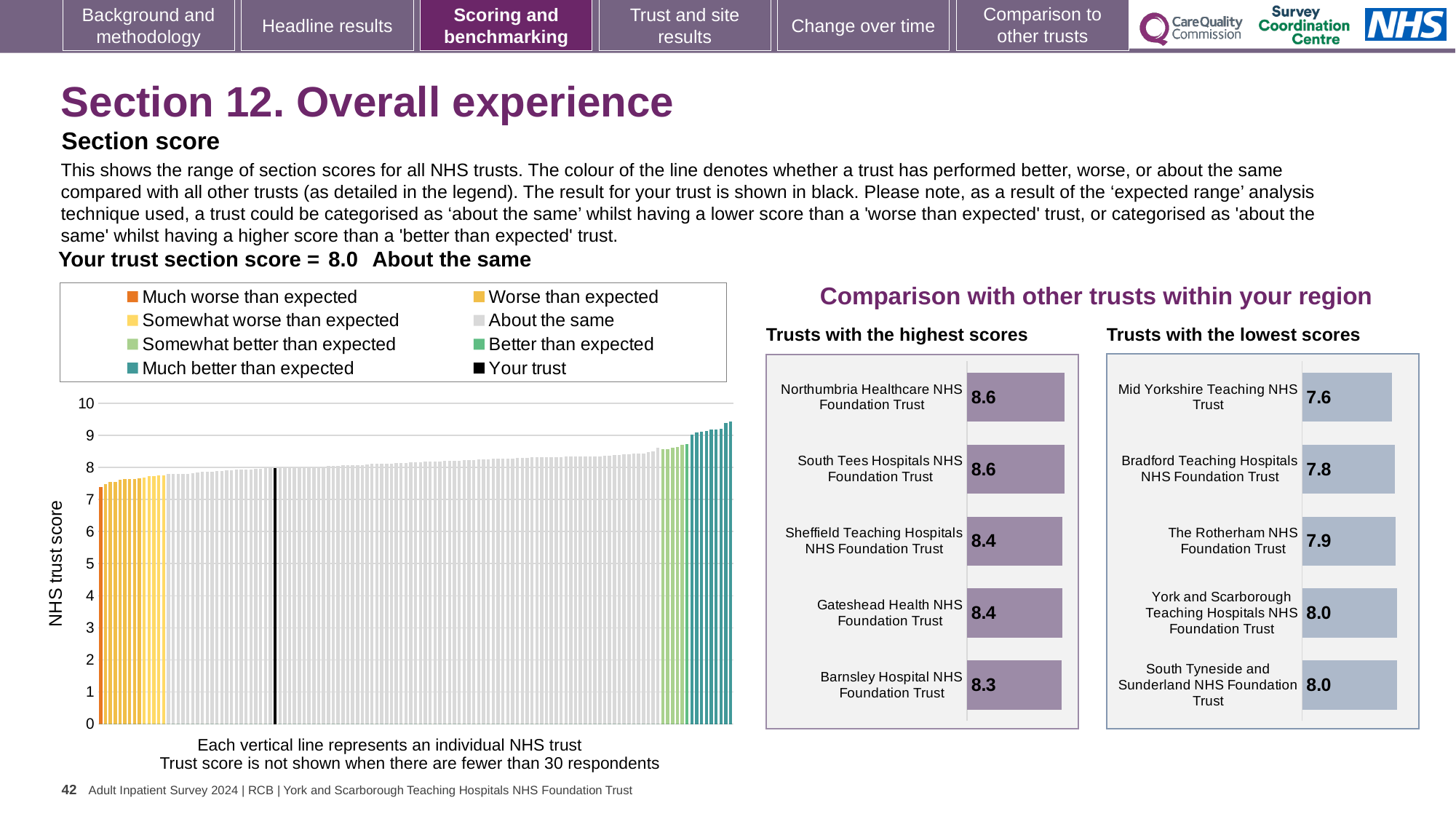
In the 'NHS trust score' chart on the left, do the values rise or fall from left to right? Rise In the 'Trusts with the highest scores' chart, how many trusts are listed? 5 What kind of chart is the 'NHS trust score' chart on the left of the slide? Bar chart How many entries does the legend of the 'NHS trust score' chart on the left list? 8 In the 'Trusts with the lowest scores' chart, what is the score for The Rotherham NHS Foundation Trust? 7.9 In the 'Trusts with the highest scores' chart, what is the score for Barnsley Hospital NHS Foundation Trust? 8.3 In the 'Trusts with the highest scores' chart, what is the difference between the scores of Northumbria Healthcare NHS Foundation Trust and Barnsley Hospital NHS Foundation Trust? 0.3 In the 'Trusts with the lowest scores' chart, which has the higher score: Mid Yorkshire Teaching NHS Trust or South Tyneside and Sunderland NHS Foundation Trust? South Tyneside and Sunderland NHS Foundation Trust In the 'Trusts with the highest scores' chart, what is the score for Northumbria Healthcare NHS Foundation Trust? 8.6 In the 'NHS trust score' chart on the left, is the value of the highest bar greater or less than 9? greater In the 'Trusts with the lowest scores' chart, what is the difference between the scores of Bradford Teaching Hospitals NHS Foundation Trust and Mid Yorkshire Teaching NHS Trust? 0.2 In the 'Trusts with the lowest scores' chart, which trust has the lowest score? Mid Yorkshire Teaching NHS Trust